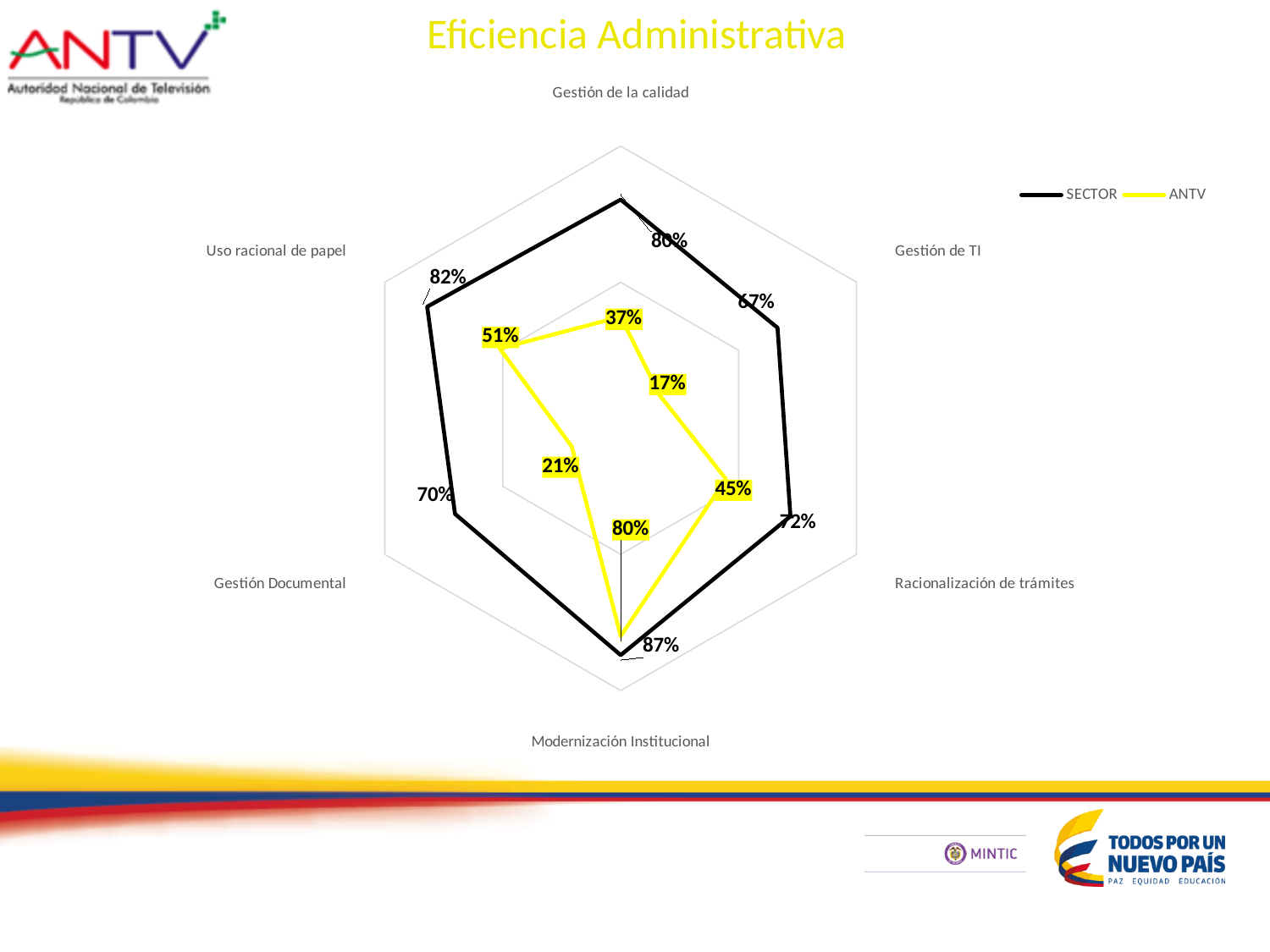
What is the ANTV value for Gestión de TI? 17% Which series has the larger value for Racionalización de trámites, SECTOR or ANTV? SECTOR How many categories (axes) does the radar chart have? 6 What is the SECTOR value for Modernización Institucional? 87% What is the difference between the SECTOR and ANTV values for Gestión de la calidad? 43% In which category does ANTV have its lowest value? Gestión de TI In which category does ANTV have its highest value? Modernización Institucional What is the ANTV value for Uso racional de papel? 51% What is the SECTOR value for Gestión Documental? 70% In which category does SECTOR have its lowest value? Gestión de TI How many series does the legend list? 2 What kind of chart is shown on the slide? Radar chart